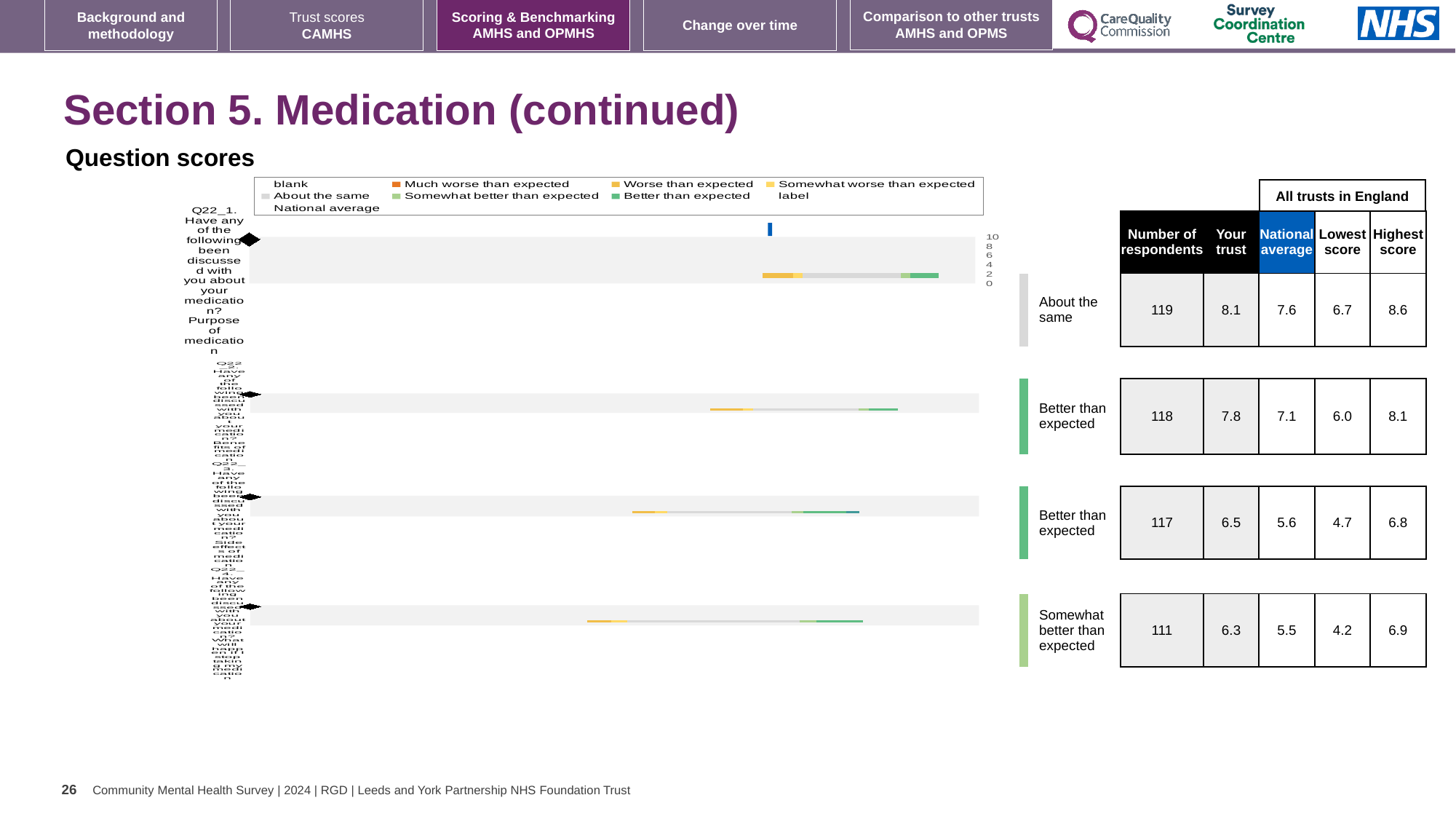
Which row of the table has the highest 'Your trust' score? the first row (Q22_1, purpose of medication), 8.1 In the table beside the chart, what is the highest score across all trusts in England for the first question (Q22_1)? 8.6 Which row of the table has the lowest number of respondents? the fourth row, 111 In the table beside the chart, what is the national average for the first question (Q22_1, purpose of medication)? 7.6 In the table beside the chart, how many respondents are listed for the first question (Q22_1, purpose of medication)? 119 How many question bars are plotted in the 'Question scores' chart? 4 What is the heading above the chart? Question scores For the first question (Q22_1), what is the difference between the 'Your trust' score (8.1) and the national average (7.6)? 0.5 What colour does the legend use for 'Better than expected'? green What kind of chart is shown under 'Question scores'? bar chart For the first question (Q22_1), which is larger: the 'Your trust' score or the national average? Your trust In the table beside the chart, what is the 'Your trust' score for the first question (Q22_1, purpose of medication)? 8.1